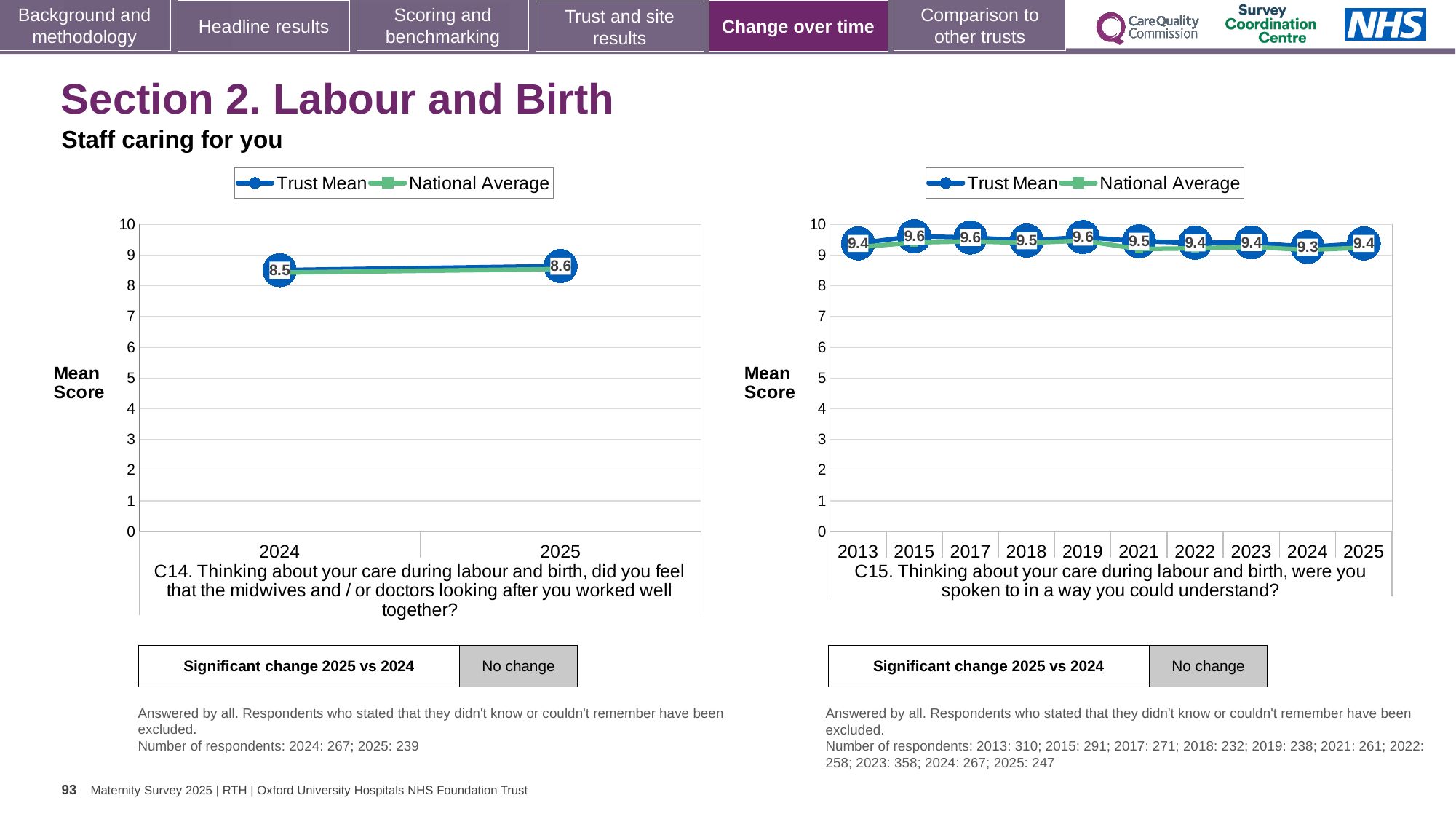
In the C14 chart on the left, what is the difference between the Trust Mean for 2025 and 2024? 0.1 In the C15 chart on the right, what is the difference between the Trust Mean for 2015 and 2024? 0.3 In the C15 chart on the right, how many years are plotted on the x axis? 10 In the C15 chart on the right, what is the Trust Mean for 2013? 9.4 In the C14 chart on the left, how many series does the legend list? 2 In the C15 chart on the right, which year has the lowest Trust Mean? 2024 In the C14 chart on the left, what is the Trust Mean for 2025? 8.6 In the C15 chart on the right, is the Trust Mean for 2019 greater or less than 9? greater In the C15 chart on the right, what is the Trust Mean for 2024? 9.3 In the C14 chart on the left, what does the 'Significant change 2025 vs 2024' box say? No change What kind of chart is the C15 chart on the right? Line chart In the C14 chart on the left, what is the Trust Mean for 2024? 8.5